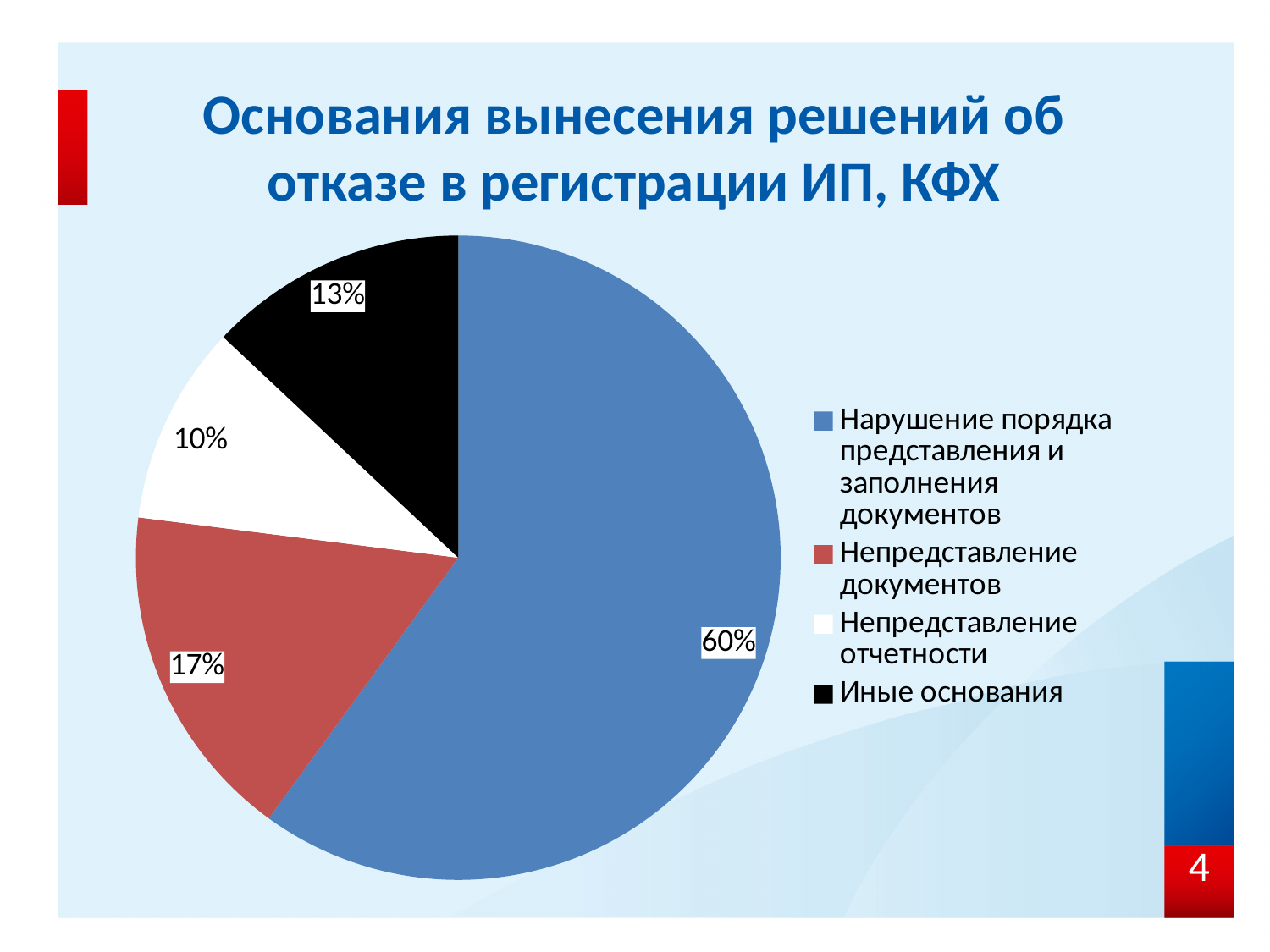
Which category has the largest slice of the pie? Нарушение порядка представления и заполнения документов What is the difference between the shares of "Непредставление документов" and "Иные основания"? 4% What share of the pie does "Иные основания" have? 13% What share of the pie does "Нарушение порядка представления и заполнения документов" have? 60% What colour is the slice for "Иные основания"? black What share of the pie does "Непредставление документов" have? 17% What is the title of the slide? Основания вынесения решений об отказе в регистрации ИП, КФХ What type of chart is shown on the slide? pie chart What share of the pie does "Непредставление отчетности" have? 10% How many categories does the pie chart have? 4 Which is larger: the share of "Иные основания" or the share of "Непредставление отчетности"? Иные основания Which category has the smallest slice of the pie? Непредставление отчетности